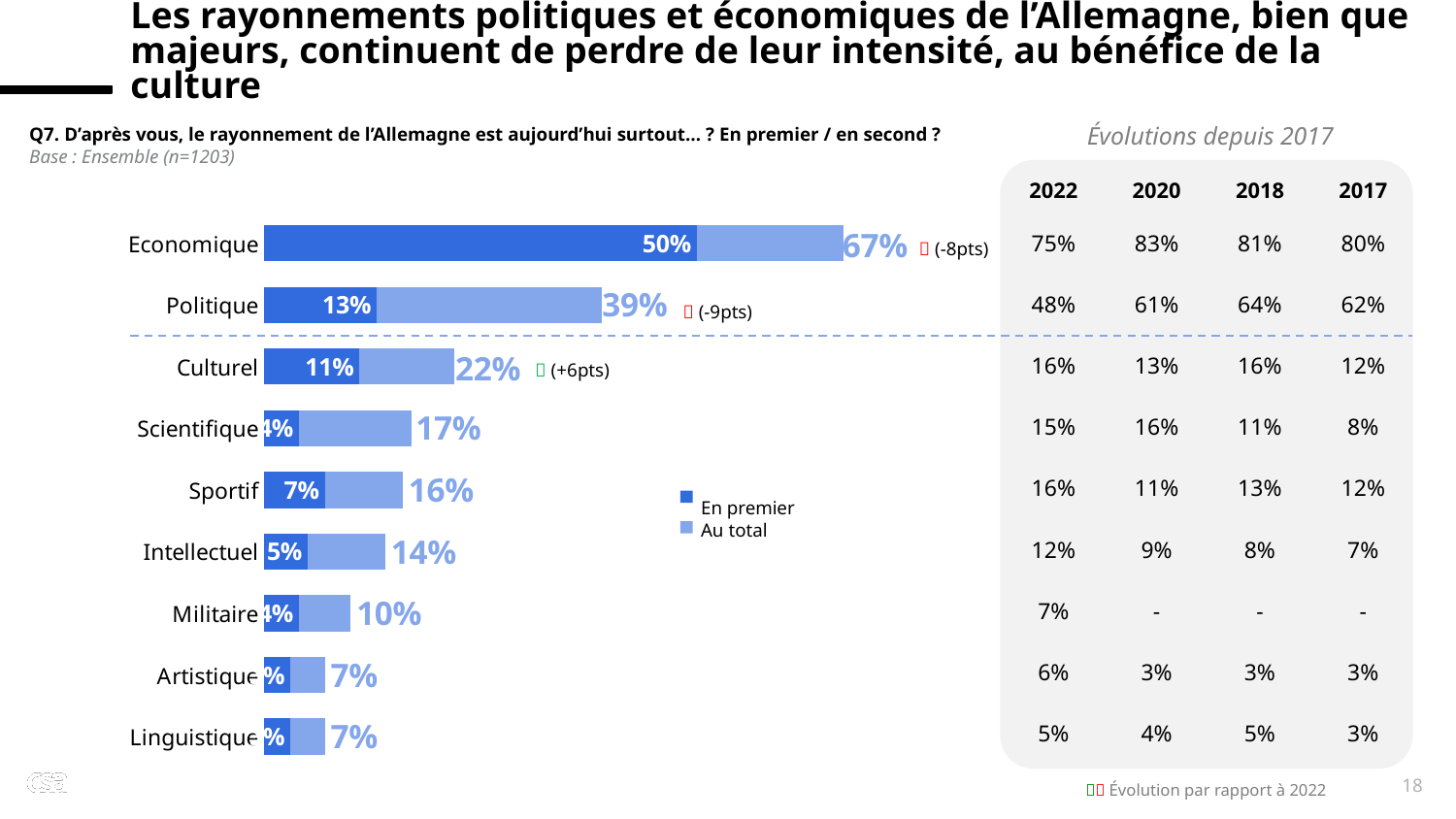
What kind of chart is shown on the slide? bar chart What is the 'Au total' value for Culturel? 22% What is the 'Au total' value for Militaire? 10% What is the difference between the 'Au total' values for Economique and Politique? 28% How many categories are plotted in the bar chart? 9 What is the 'Au total' value for Economique? 67% Which has a larger 'Au total' value, Scientifique or Sportif? Scientifique What are the two legend entries of the chart? En premier, Au total How many series does the chart legend list? 2 What is the 'En premier' value for Politique? 13% Which category has the highest 'Au total' value? Economique What is the 'En premier' value for Sportif? 7%